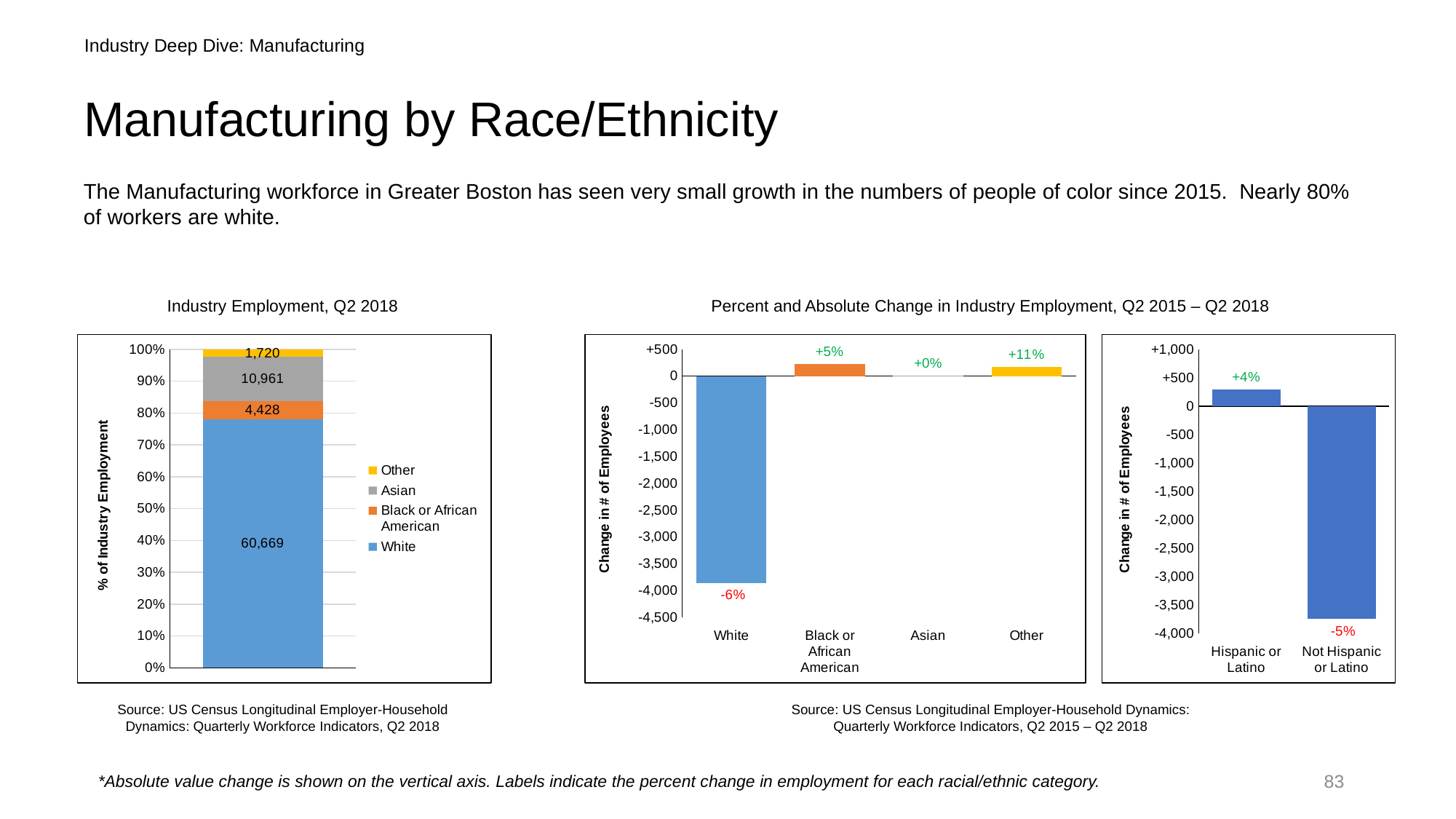
In the 'Industry Employment, Q2 2018' chart, what is the value shown for Asian? 10,961 In the 'Industry Employment, Q2 2018' chart, what is the value shown for White? 60,669 In the 'Industry Employment, Q2 2018' chart, what is the total of all four segments of the stacked bar? 77,778 In the middle chart (Percent and Absolute Change in Industry Employment), what percent change label is shown for Other? +11% In the 'Industry Employment, Q2 2018' chart, which group has the smallest number of employees? Other In the middle chart (Percent and Absolute Change in Industry Employment), is the change in number of employees for White greater or less than -3,500? less In the middle chart (Percent and Absolute Change in Industry Employment), what percent change label is shown for White? -6% In the rightmost chart, what percent change label is shown for Hispanic or Latino? +4% In the rightmost chart, is the change in number of employees for Not Hispanic or Latino greater or less than -3,000? less In the 'Industry Employment, Q2 2018' chart, what is the difference between the Asian value and the Black or African American value? 6,533 In the 'Industry Employment, Q2 2018' chart, which group has the largest number of employees? White How many series does the legend of the 'Industry Employment, Q2 2018' chart list? 4